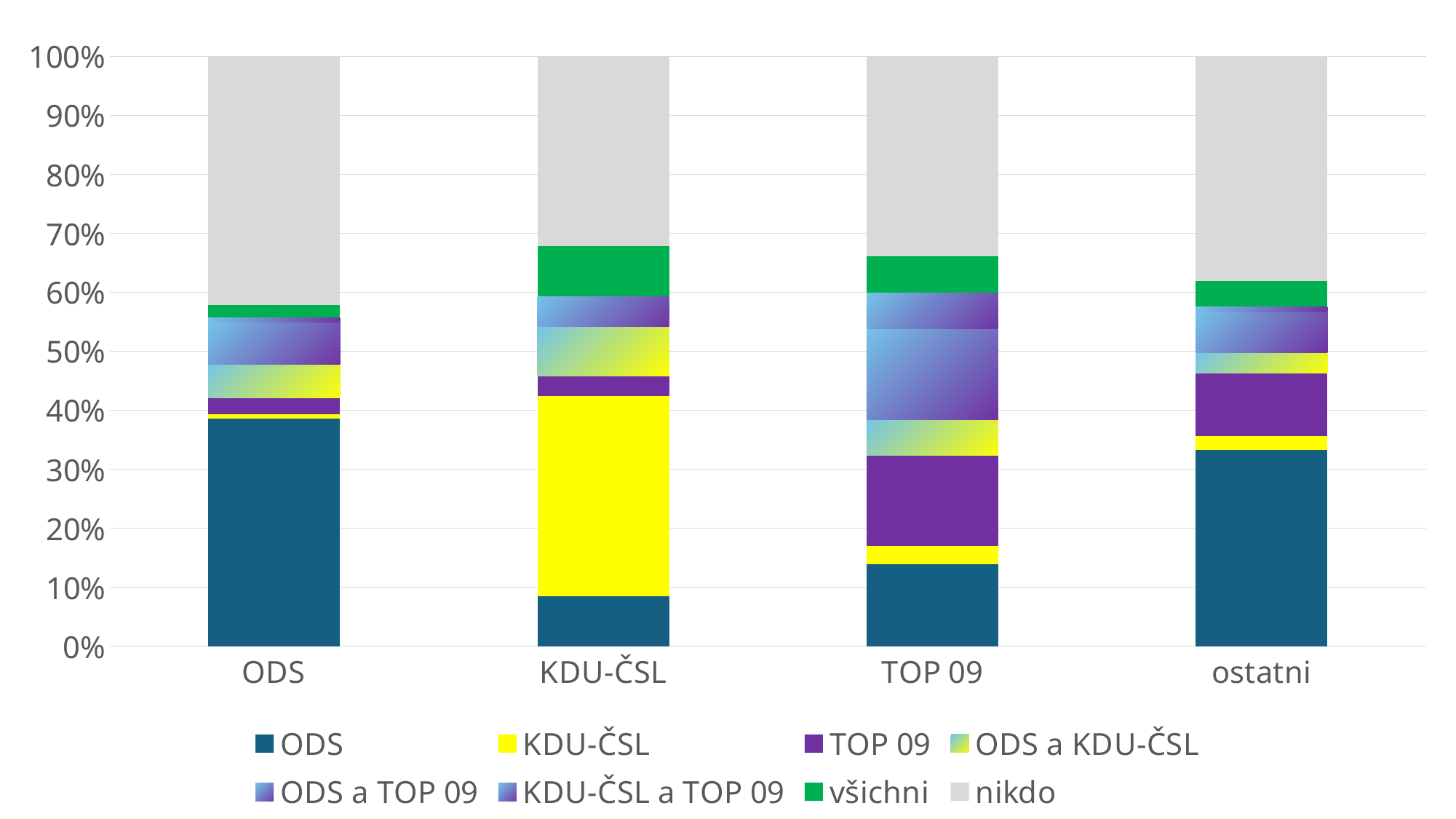
How many series does the legend list? 8 Is the ODS segment in the TOP 09 bar greater or less than 20%? less How many categories are shown on the x axis? 4 Which category has the largest KDU-ČSL segment? KDU-ČSL Is the nikdo segment in the KDU-ČSL bar greater or less than 40%? less Is the ODS segment in the ODS bar greater or less than 30%? greater What colour represents the nikdo series in the legend? grey Which is larger: the KDU-ČSL segment in the KDU-ČSL bar or the KDU-ČSL segment in the ODS bar? KDU-ČSL bar Which category has the largest ODS segment? ODS Which category has the largest nikdo segment? ODS What kind of chart is shown on the slide? stacked bar chart